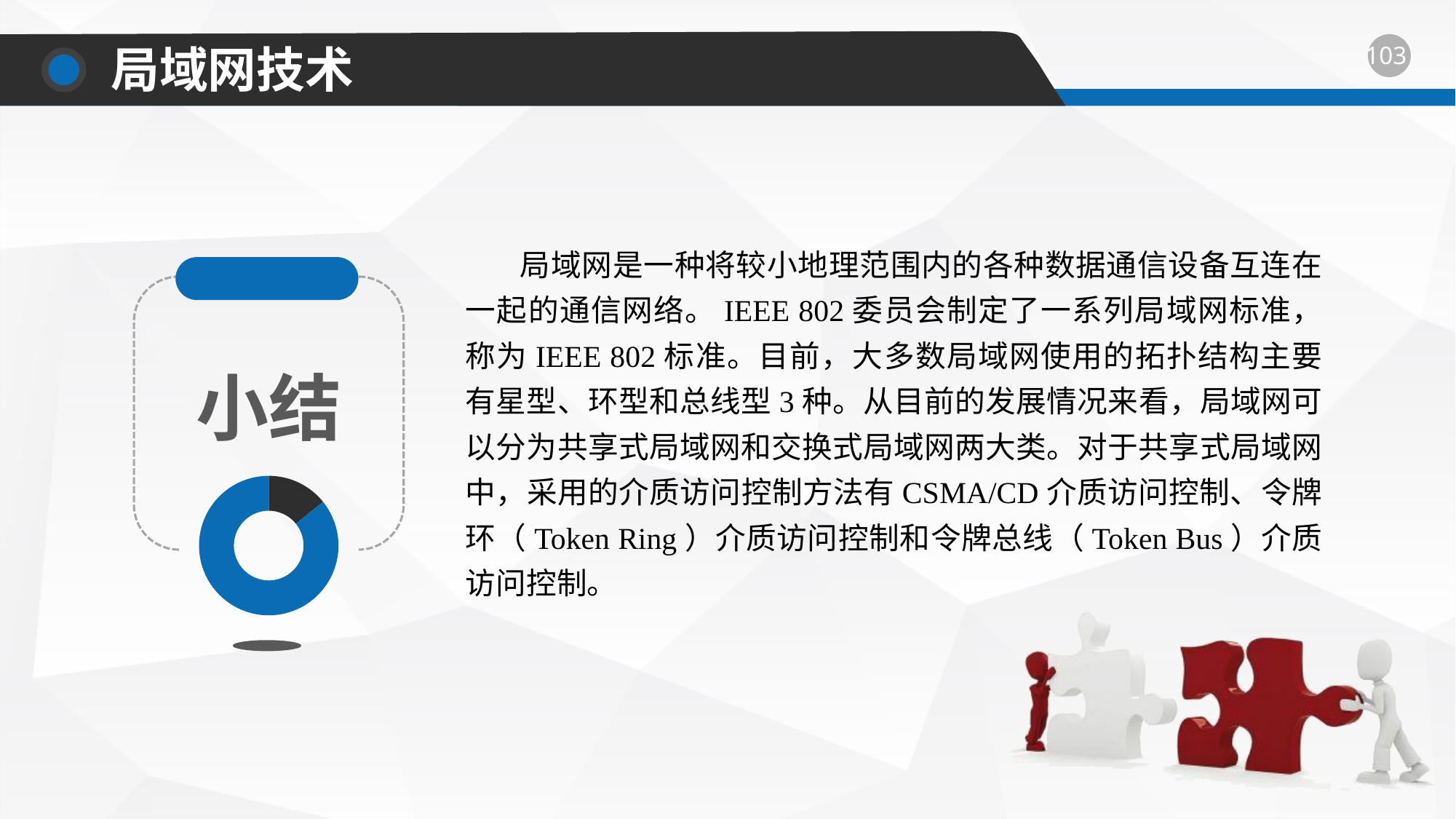
What kind of chart is shown on the left of the slide below the word 小结? Donut (pie) chart What colour is the smaller slice of the donut chart on the left of the slide? Dark grey How many slices does the donut chart on the left of the slide have? 2 Does the donut chart on the left of the slide show any data labels or a legend? No In the donut chart on the left of the slide, which slice is larger, the blue one or the dark grey one? The blue one